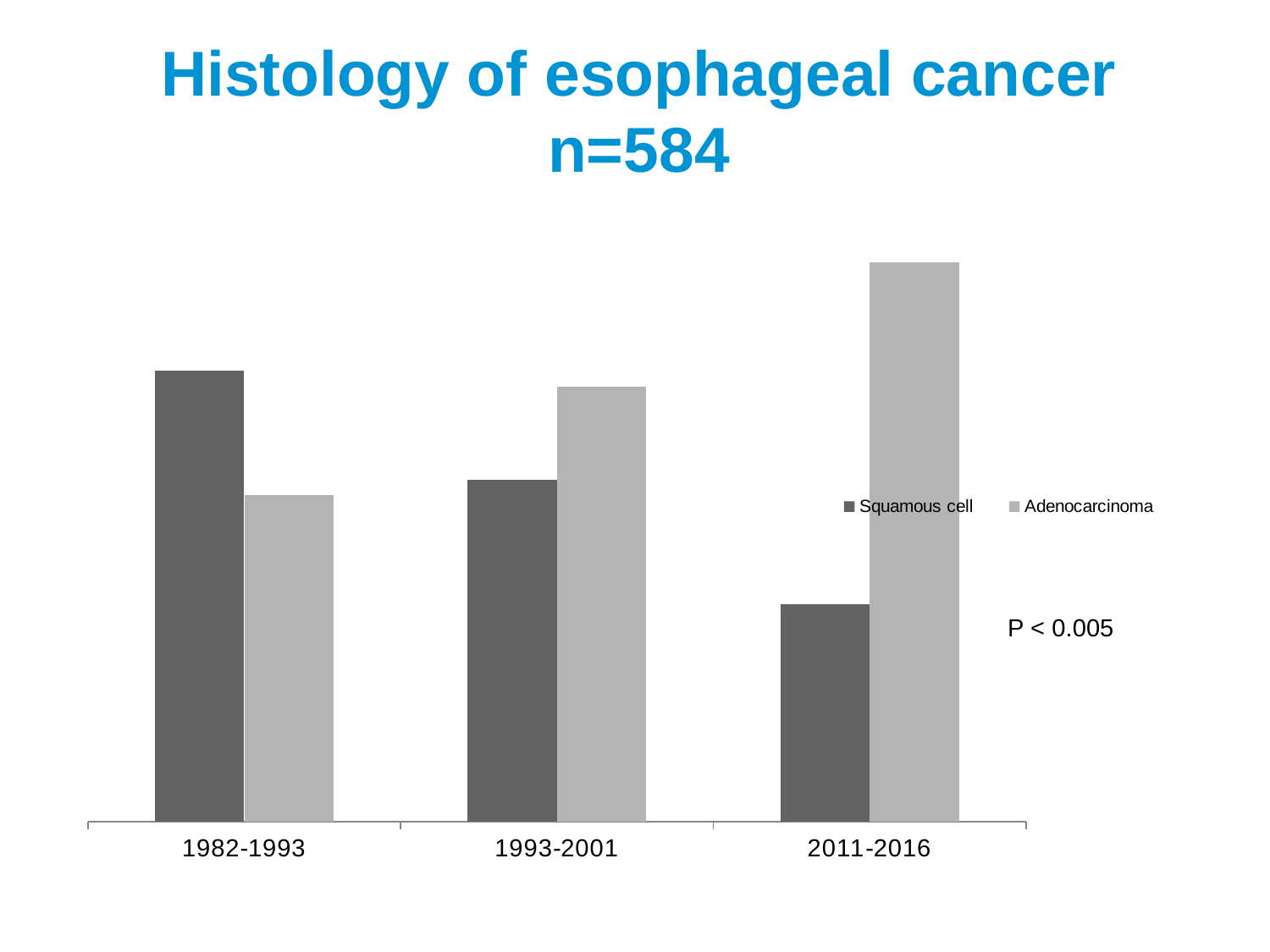
In which period is the Squamous cell bar highest? 1982-1993 In which period is the Adenocarcinoma bar highest? 2011-2016 How many series does the legend list? 2 In 2011-2016, which is larger: Squamous cell or Adenocarcinoma? Adenocarcinoma Do the Adenocarcinoma values rise or fall across the periods from 1982-1993 to 2011-2016? rise In which period is the Adenocarcinoma bar lowest? 1982-1993 How many time periods are shown on the x axis? 3 What kind of chart is shown on the slide? bar chart In which period is the Squamous cell bar lowest? 2011-2016 Which two series are listed in the legend? Squamous cell and Adenocarcinoma Do the Squamous cell values rise or fall across the periods from 1982-1993 to 2011-2016? fall In 1982-1993, which is larger: Squamous cell or Adenocarcinoma? Squamous cell